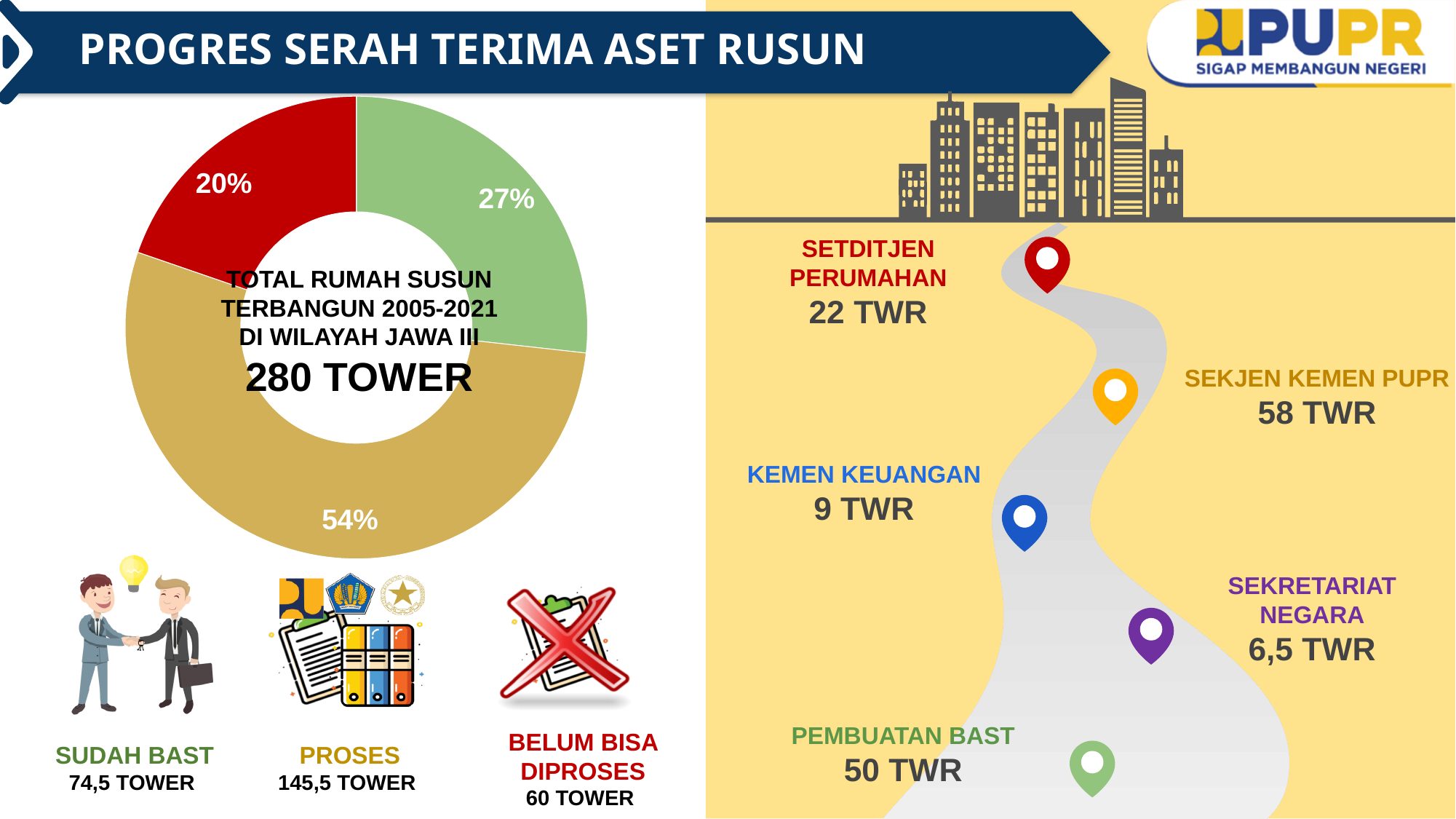
How many slices does the pie chart have? 3 What kind of chart is shown on the left of the slide? pie chart (doughnut) Which category has the largest slice in the pie chart? PROSES What total number of towers is shown in the centre of the pie chart? 280 TOWER What percentage of the pie chart does the BELUM BISA DIPROSES slice represent? 20% What percentage of the pie chart does the SUDAH BAST slice represent? 27% How many towers are listed for the PROSES category below the pie chart? 145,5 TOWER What colour is the PROSES slice in the pie chart? gold What is the difference in percentage points between the PROSES slice and the SUDAH BAST slice? 27 Which category has the smallest slice in the pie chart? BELUM BISA DIPROSES What percentage of the pie chart does the PROSES slice represent? 54% Which slice is larger in the pie chart, SUDAH BAST or BELUM BISA DIPROSES? SUDAH BAST